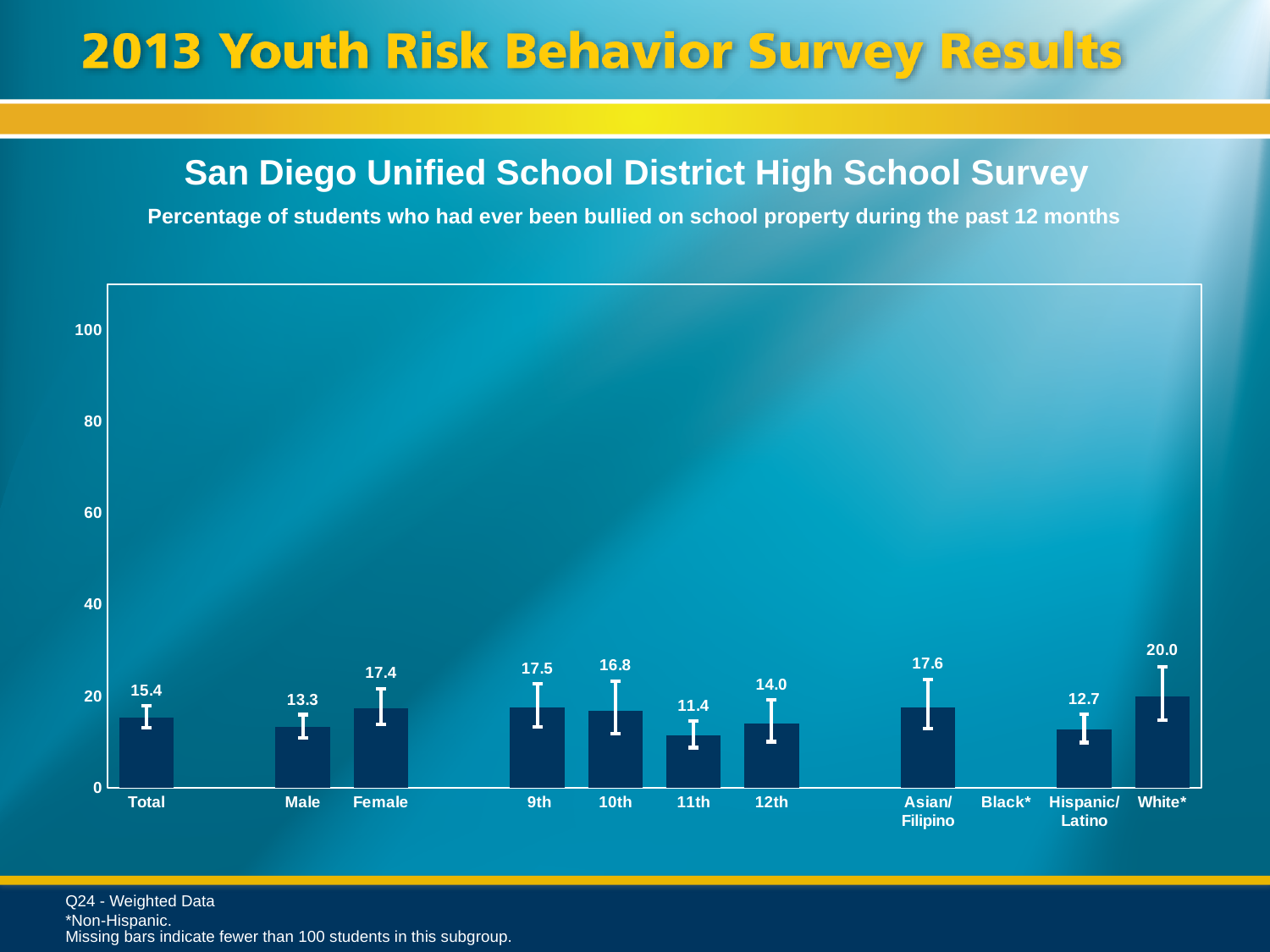
Which category has no bar plotted? Black* What is the difference between the Female and Male values? 4.1 How many categories are labelled on the x axis? 11 Which category has the highest value? White* What is the value for Female? 17.4 What is the value for 11th grade? 11.4 Is the value for White* greater or less than 40? less What kind of chart is this? bar chart What is the value for Asian/Filipino? 17.6 What is the value for Total? 15.4 Which category with a plotted bar has the lowest value? 11th Which is larger, the value for 9th or the value for 12th? 9th